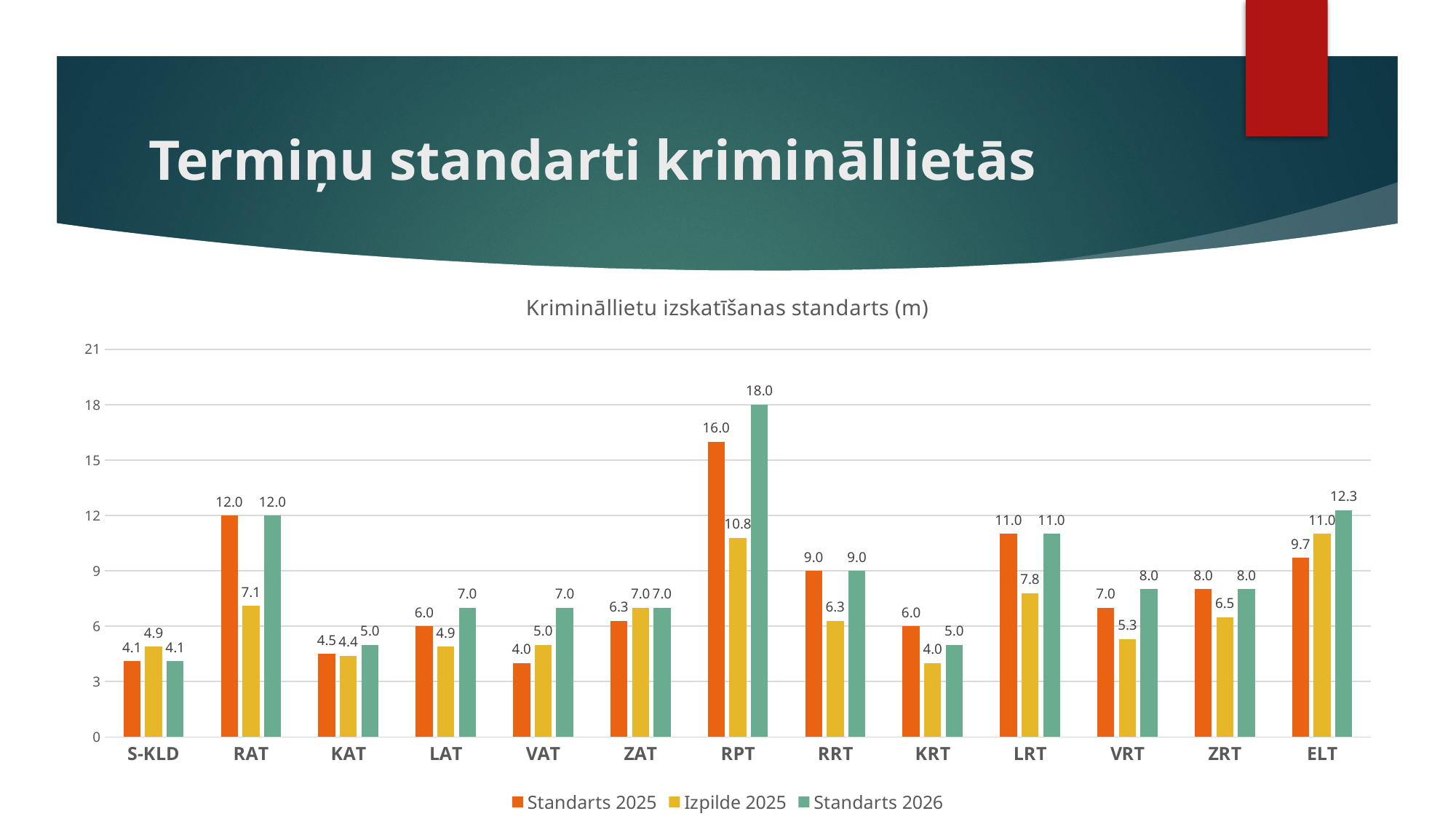
What is the Standarts 2026 value for RPT? 18.0 What kind of chart is shown on the slide? Bar chart What is the title of the chart? Krimināllietu izskatīšanas standarts (m) Which category has the lowest Izpilde 2025 value? KRT How many series does the legend list? 3 What is the Izpilde 2025 value for LRT? 7.8 Which is larger for ZRT: Standarts 2025 or Izpilde 2025? Standarts 2025 What is the Standarts 2025 value for ELT? 9.7 What is the difference between the Standarts 2026 and Izpilde 2025 values for RPT? 7.2 How many categories are shown on the x axis? 13 Which category has the highest Standarts 2025 value? RPT Is the Standarts 2026 value for ELT greater or less than 12? greater